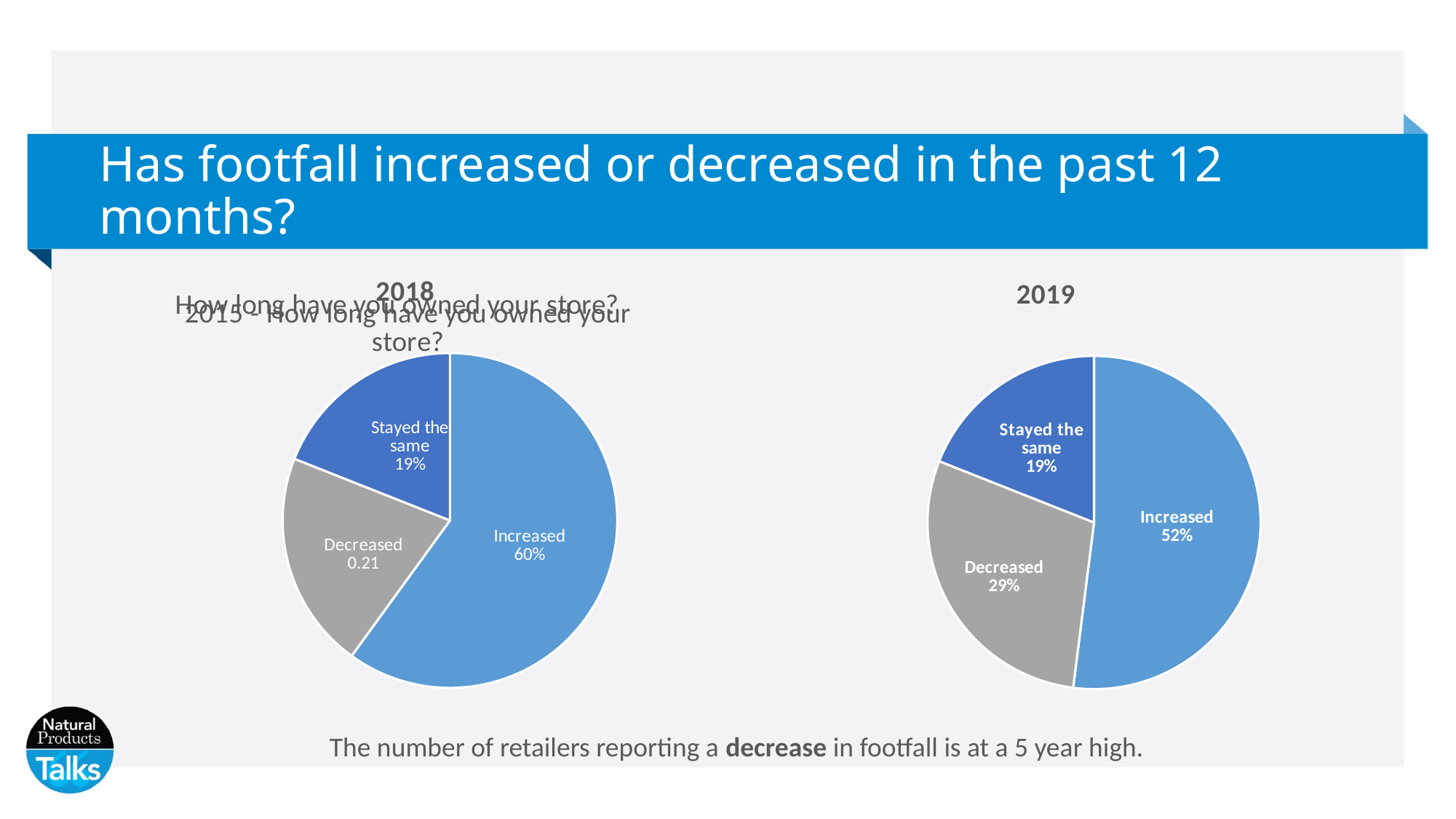
In the 2019 pie chart, which category has the largest slice? Increased Which is larger: the Increased share in the 2018 pie chart or the Increased share in the 2019 pie chart? 2018 In the 2019 pie chart, what share of retailers reported that footfall decreased? 29% In the 2019 pie chart, what share of retailers reported that footfall increased? 52% In the 2018 pie chart, what share of retailers said footfall stayed the same? 19% How many slices does the 2019 pie chart have? 3 What type of chart is used for the 2019 data? Pie chart In the 2018 pie chart, what share of retailers reported that footfall increased? 60% In the 2018 pie chart, which category has the smallest slice? Stayed the same In the 2019 pie chart, which category has the smallest slice? Stayed the same In the 2018 pie chart, what value is printed on the Decreased slice? 0.21 In the 2019 pie chart, what is the difference between the Increased and Decreased shares? 23%